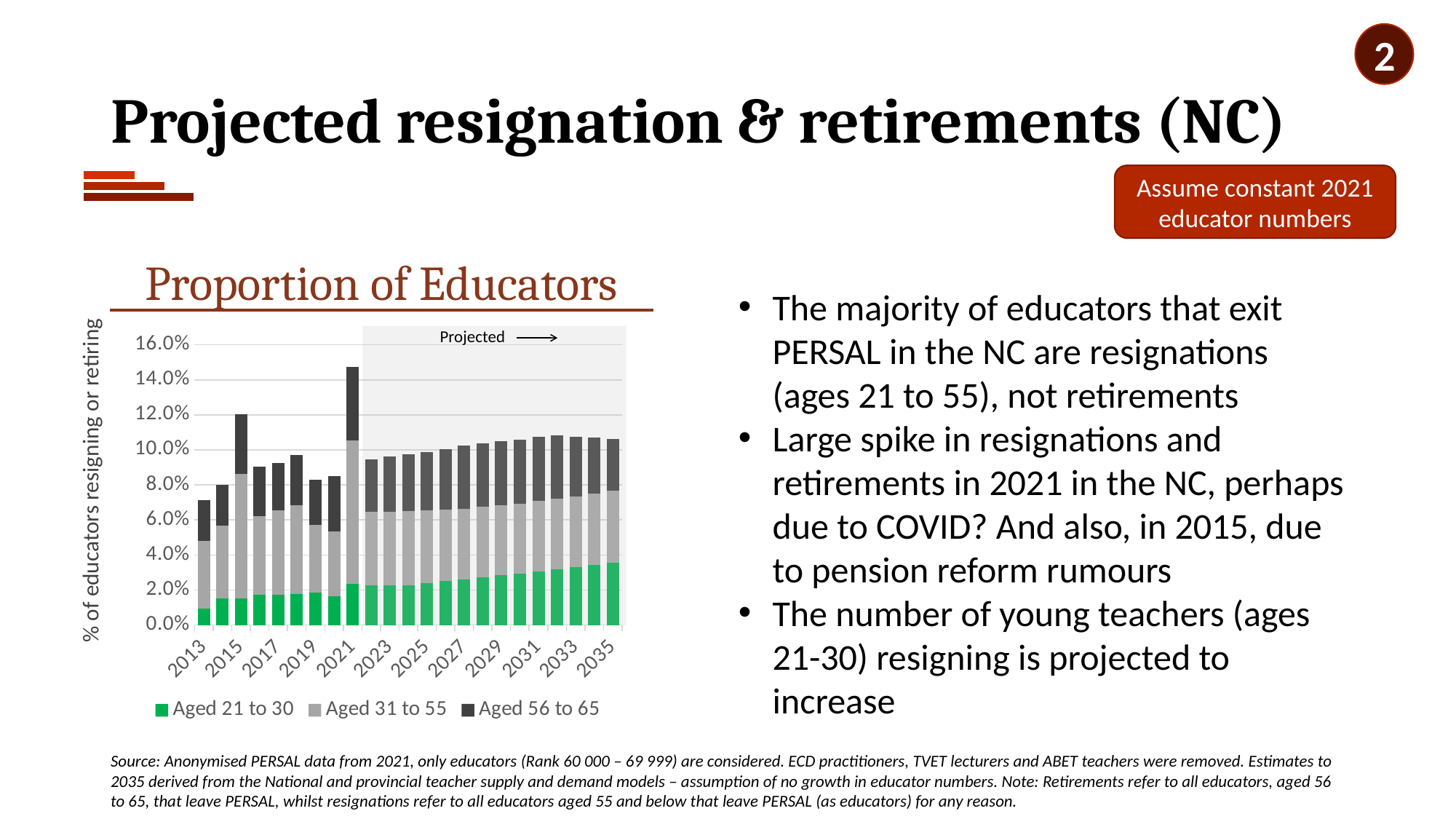
What kind of chart is shown under the title "Proportion of Educators"? Stacked bar chart Is the total value for 2013 greater or less than 8.0%? less Which year has the highest total proportion of educators resigning or retiring? 2021 Is the total value for 2035 greater or less than 10.0%? greater Which colour represents the "Aged 21 to 30" series in the legend? Green Does the "Aged 21 to 30" segment rise or fall across the projected years from 2022 to 2035? Rise Which year has the lowest total proportion of educators resigning or retiring? 2013 How many series does the legend of the "Proportion of Educators" chart list? 3 What is the label on the vertical axis of the chart? % of educators resigning or retiring Which year has a larger total bar, 2015 or 2021? 2021 Is the total value for 2021 greater or less than 14.0%? greater How many years (bars) are plotted in the "Proportion of Educators" chart? 23